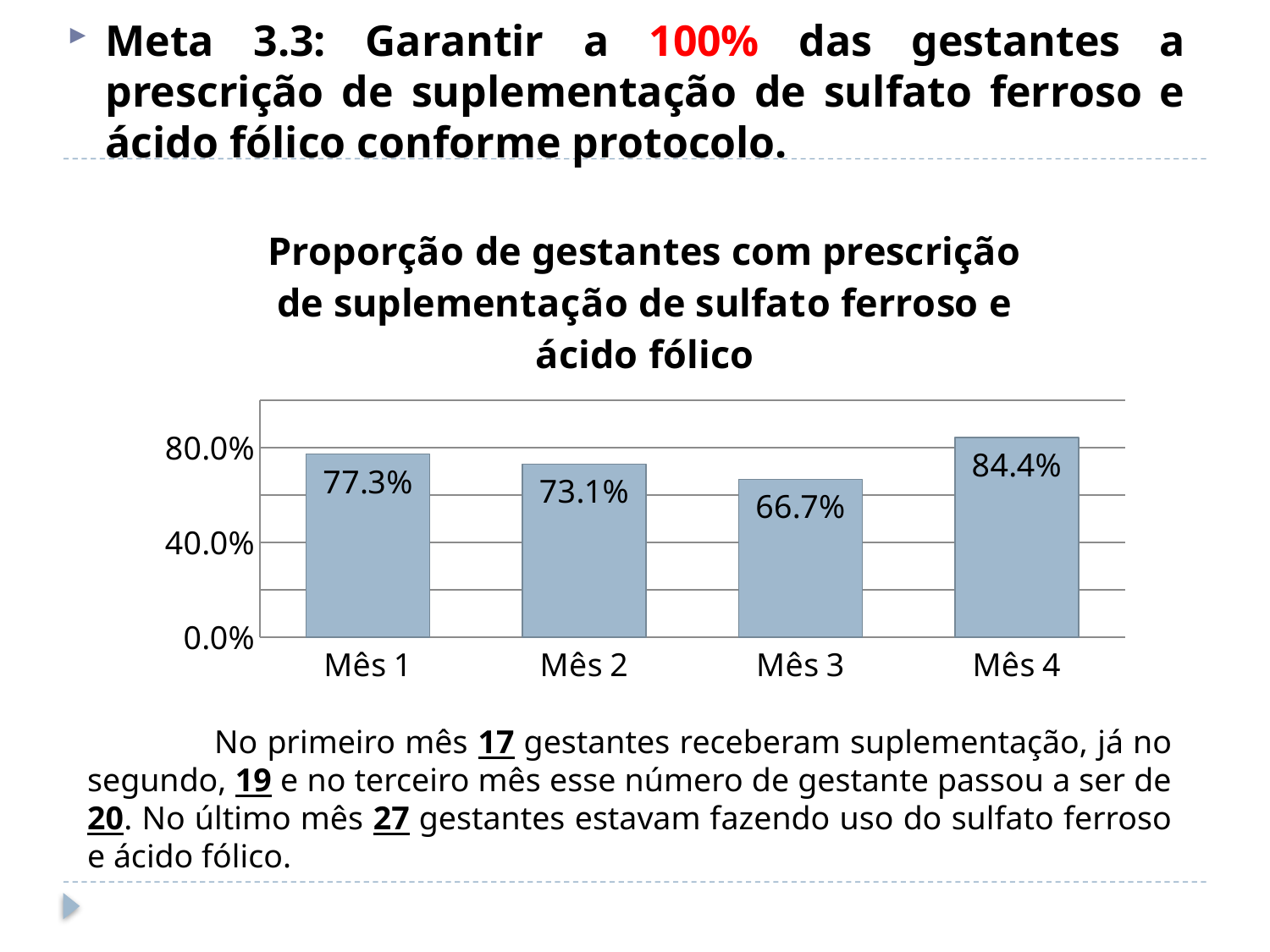
What is the value for Mês 3? 66.7% What kind of chart is shown on the slide? bar chart Which month has the lowest value? Mês 3 What is the title of the chart? Proporção de gestantes com prescrição de suplementação de sulfato ferroso e ácido fólico Do the values rise or fall from Mês 1 to Mês 3? fall Which is larger, the value for Mês 1 or the value for Mês 2? Mês 1 How many months are shown on the x axis? 4 What is the difference between the values for Mês 4 and Mês 3? 17.7% Which month has the highest value? Mês 4 What is the value for Mês 1? 77.3% Is the value for Mês 2 greater or less than 80.0%? less What is the value for Mês 4? 84.4%